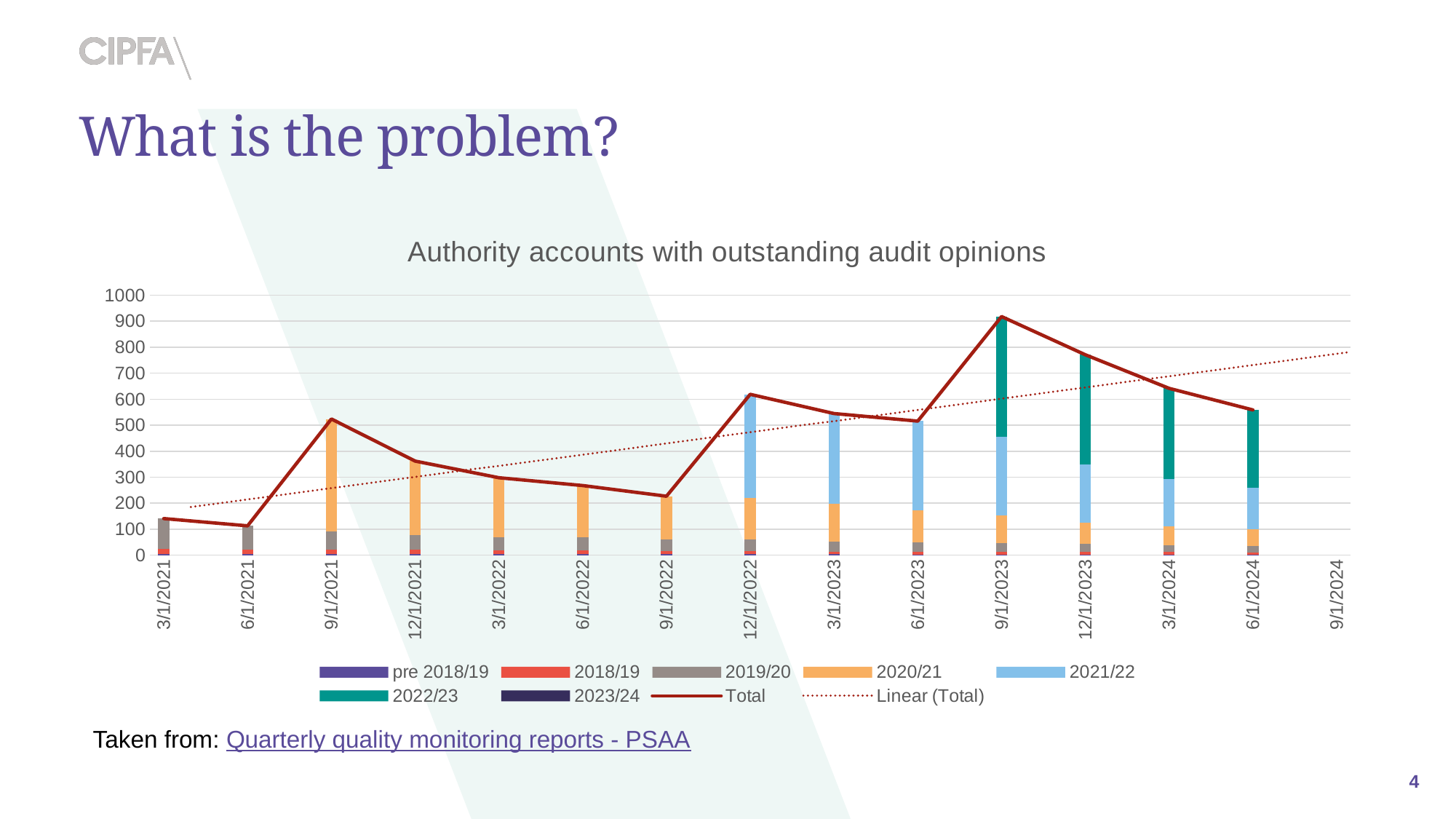
How many entries does the chart legend list? 9 Does the Total line rise or fall between 9/1/2023 and 6/1/2024? fall Which legend entry is shown as a dotted line? Linear (Total) What kind of chart is used to show the yearly breakdown of outstanding audit opinions? Stacked bar chart with a line for the total Is the Total value for 12/1/2023 greater or less than 700? greater At which date is the Total line at its lowest value? 6/1/2021 Which date has a larger Total, 9/1/2022 or 12/1/2022? 12/1/2022 Is the Total value for 6/1/2024 greater or less than 600? less Is the Total value for 6/1/2021 greater or less than 200? less At which date does the Total line reach its highest value? 9/1/2023 What is the title of the chart? Authority accounts with outstanding audit opinions